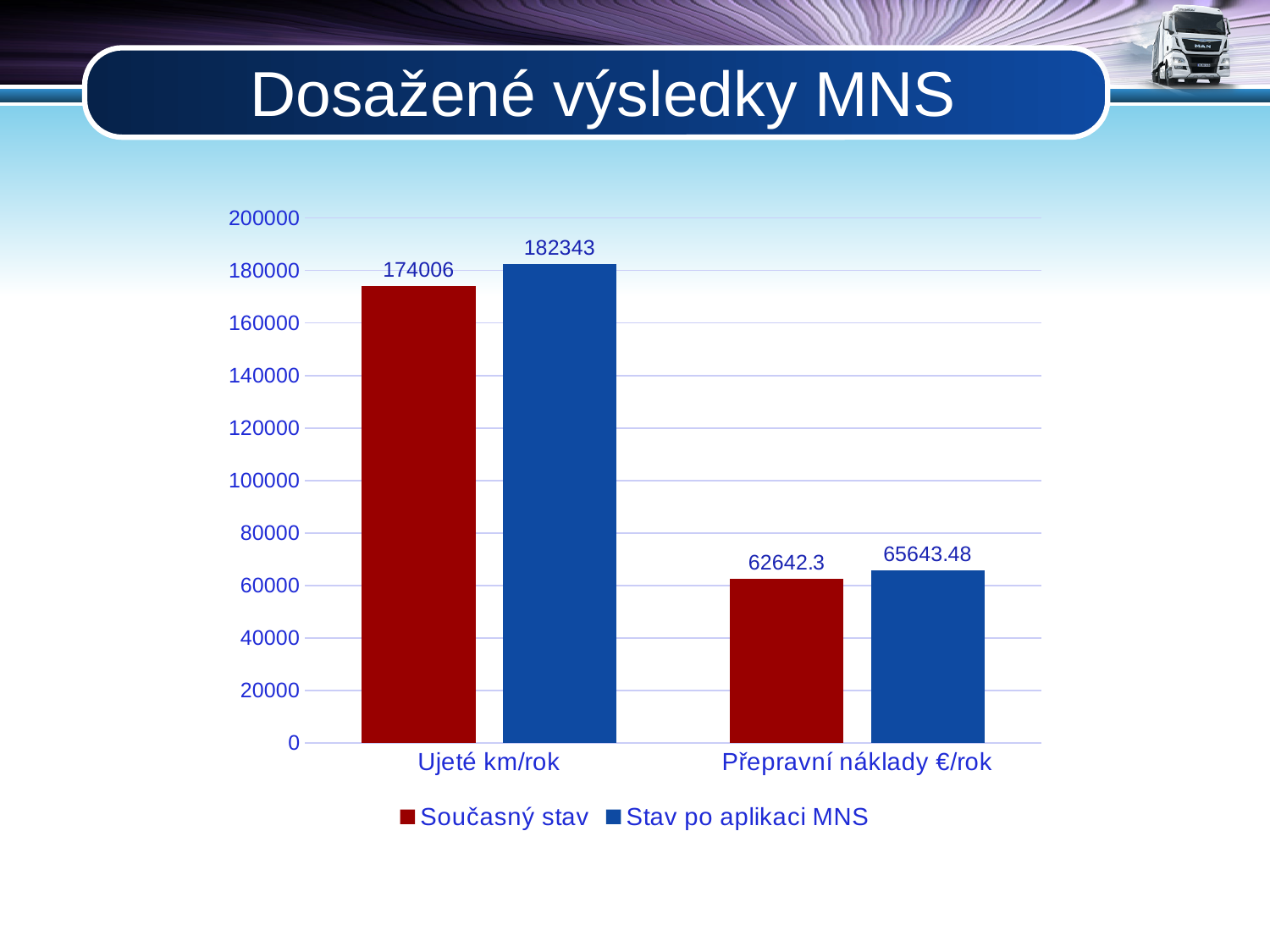
What is the value of "Stav po aplikaci MNS" for "Přepravní náklady €/rok"? 65643.48 How many series does the legend list? 2 What is the difference between "Stav po aplikaci MNS" and "Současný stav" for "Ujeté km/rok"? 8337 How many categories are shown on the x axis? 2 What type of chart is shown on the slide? bar chart What is the value of "Současný stav" for "Ujeté km/rok"? 174006 Is the value of "Současný stav" for "Přepravní náklady €/rok" greater or less than 80000? less Which category has the lowest value for "Současný stav"? Přepravní náklady €/rok What is the value of "Stav po aplikaci MNS" for "Ujeté km/rok"? 182343 What is the difference between "Stav po aplikaci MNS" and "Současný stav" for "Přepravní náklady €/rok"? 3001.18 Which series has the higher value for "Ujeté km/rok"? Stav po aplikaci MNS What is the value of "Současný stav" for "Přepravní náklady €/rok"? 62642.3